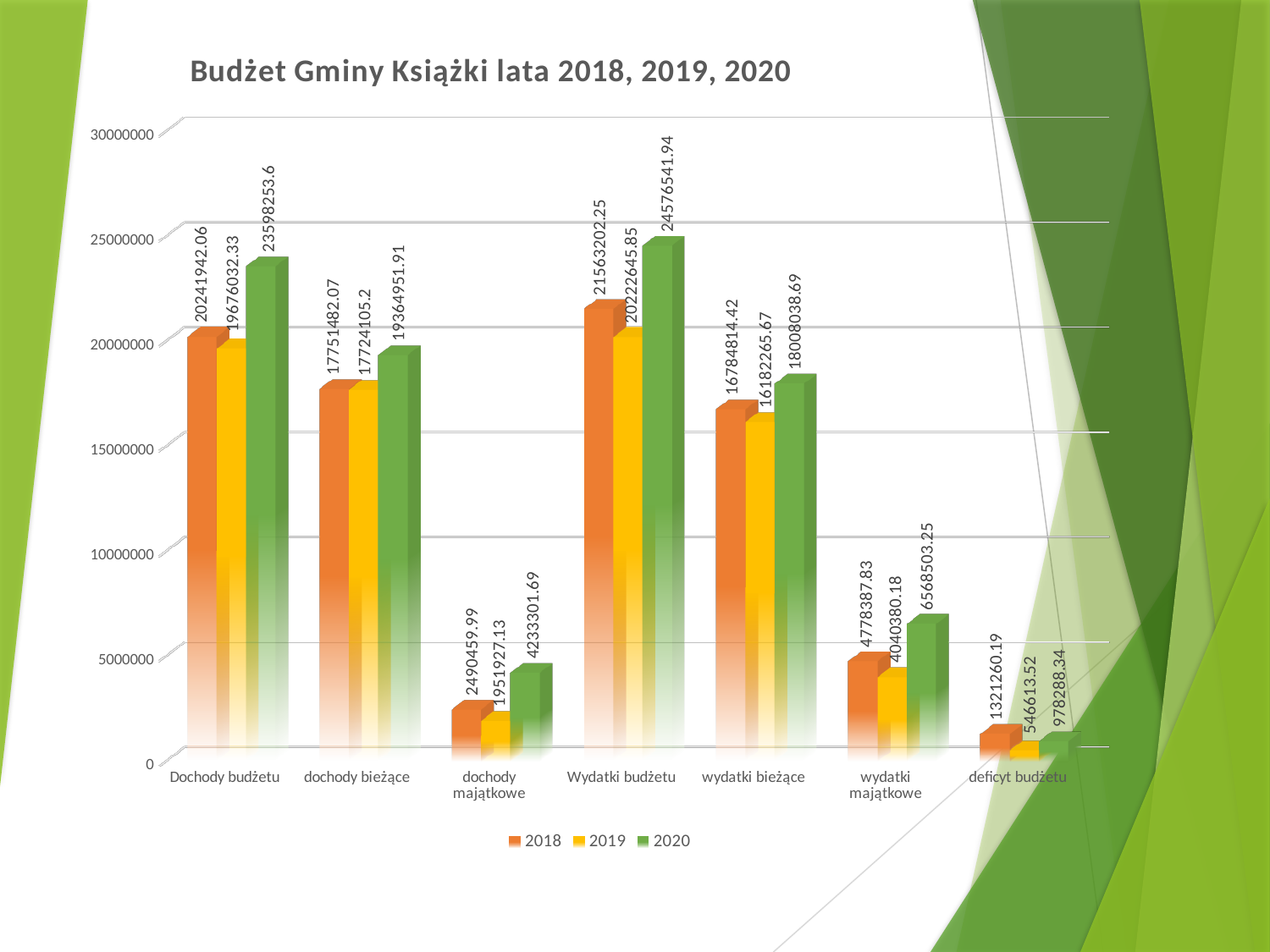
What is the value for deficyt budżetu in 2019? 546613.52 How many categories are shown on the x axis? 7 Which category has the lowest value for the 2019 series? deficyt budżetu What is the value for dochody bieżące in 2019? 17724105.2 Which is larger for deficyt budżetu: the 2018 value or the 2020 value? 2018 Which category has the highest value for the 2020 series? Wydatki budżetu What is the value for Dochody budżetu in 2020? 23598253.6 How many series does the legend list? 3 What is the value for wydatki majątkowe in 2018? 4778387.83 What is the difference between the 2020 and 2019 values for dochody majątkowe? 2281374.56 What is the difference between the 2020 and 2018 values for Wydatki budżetu? 3013339.69 What type of chart is shown on the slide? bar chart